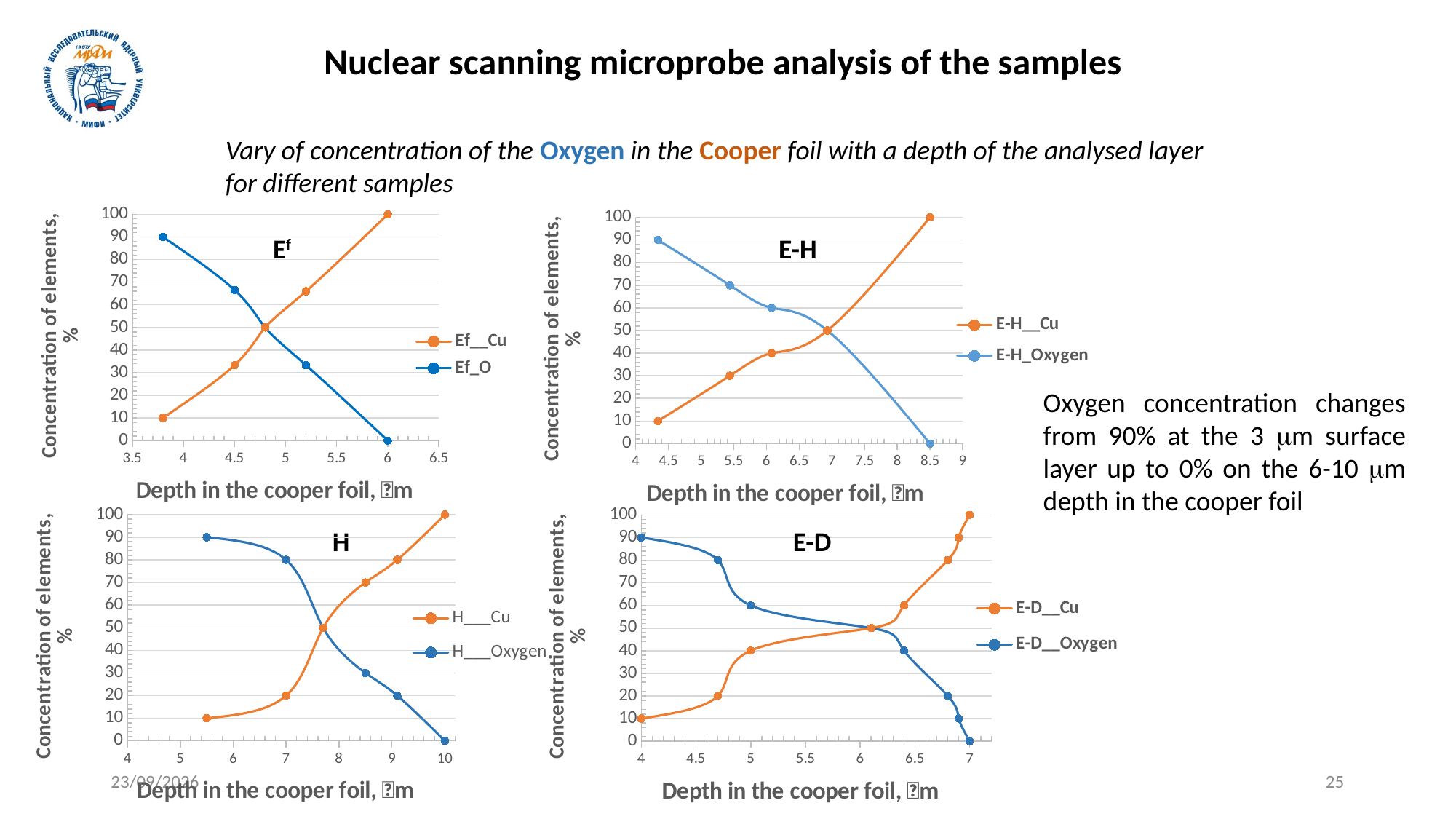
In the E-D chart, what is the value of E-D__Cu at a depth of 7 μm? 100 In the E-H chart, is the value of E-H_Oxygen at a depth of 5.5 μm greater or less than 60? greater In the E-D chart, does the E-D__Cu series rise or fall as depth increases? rise In the Ef chart, what is the value of Ef_O at a depth of 6 μm? 0 In the E-H chart, what is the value of E-H_Oxygen at a depth of 8.5 μm? 0 In the H chart, does the H___Oxygen series rise or fall as depth increases? fall In the Ef chart, is the value of Ef__Cu at a depth of 4.5 μm greater or less than 40? less In the Ef chart, what is the value of Ef__Cu at a depth of 6 μm? 100 What kind of chart is the chart titled Ef? line chart In the Ef chart, which series has the larger value at a depth of 6 μm, Ef__Cu or Ef_O? Ef__Cu How many series does the legend of the E-H chart list? 2 In the H chart, how many data points does the H___Cu series have? 6